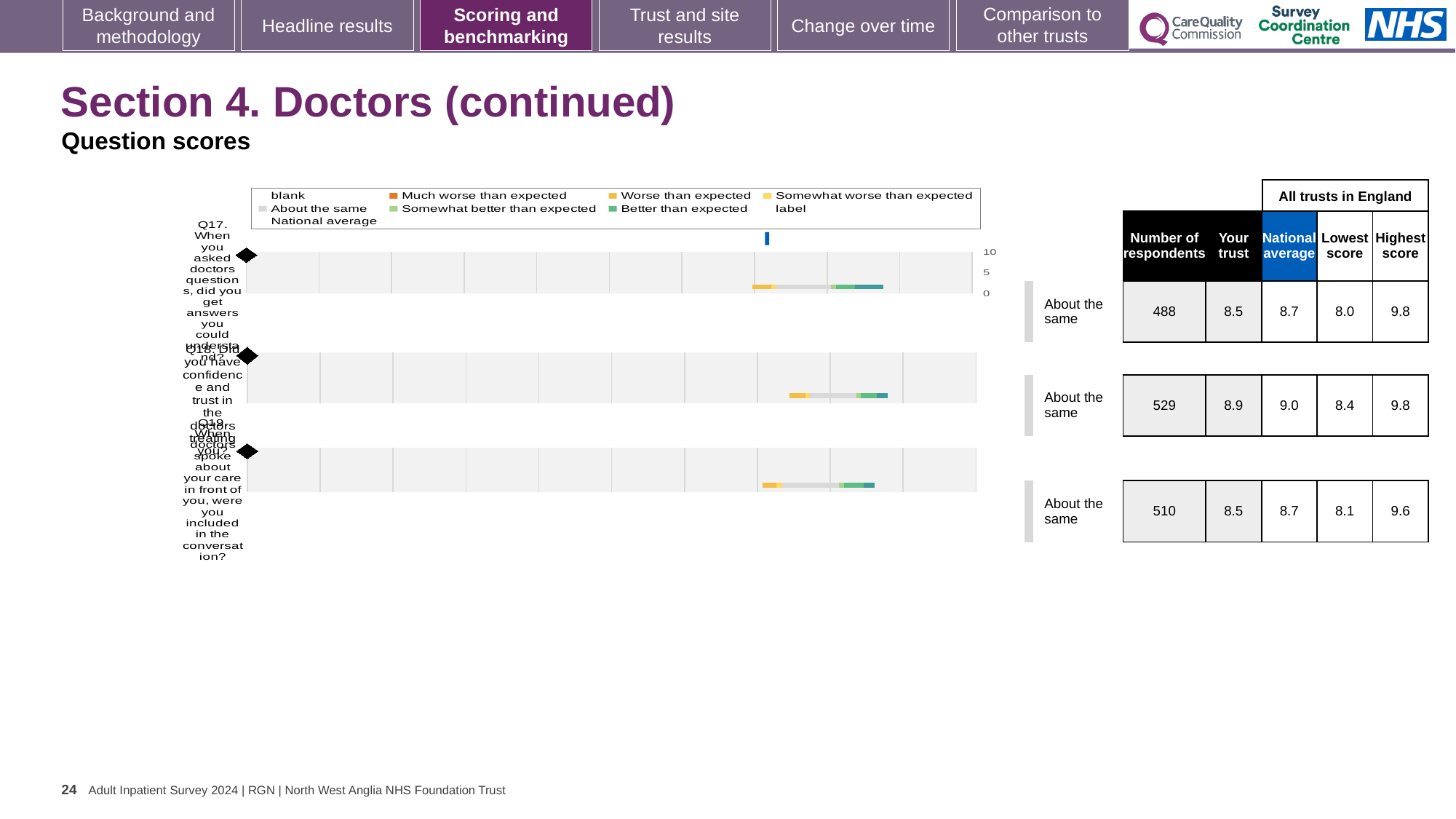
How many questions (categories) are plotted in the chart? 3 What is the benchmark category shown for Q17 (answers you could understand)? About the same What is the benchmark category shown for Q18 (confidence and trust in doctors)? About the same In the table beside the chart, what is the 'Your trust' score for Q17? 8.5 What kind of chart is shown on the slide? bar chart Which colour in the legend represents 'Much worse than expected'? orange In the table beside the chart, is the highest score for Q19 larger or smaller than the highest score for Q18? smaller In the table beside the chart, what is the difference between the national average and 'Your trust' score for Q17? 0.2 In the table beside the chart, which question has the highest 'Your trust' score? Q18 In the table beside the chart, how many respondents answered Q19? 510 In the table beside the chart, what is the national average for Q18? 9.0 What is the highest tick value shown on the chart's score axis? 10